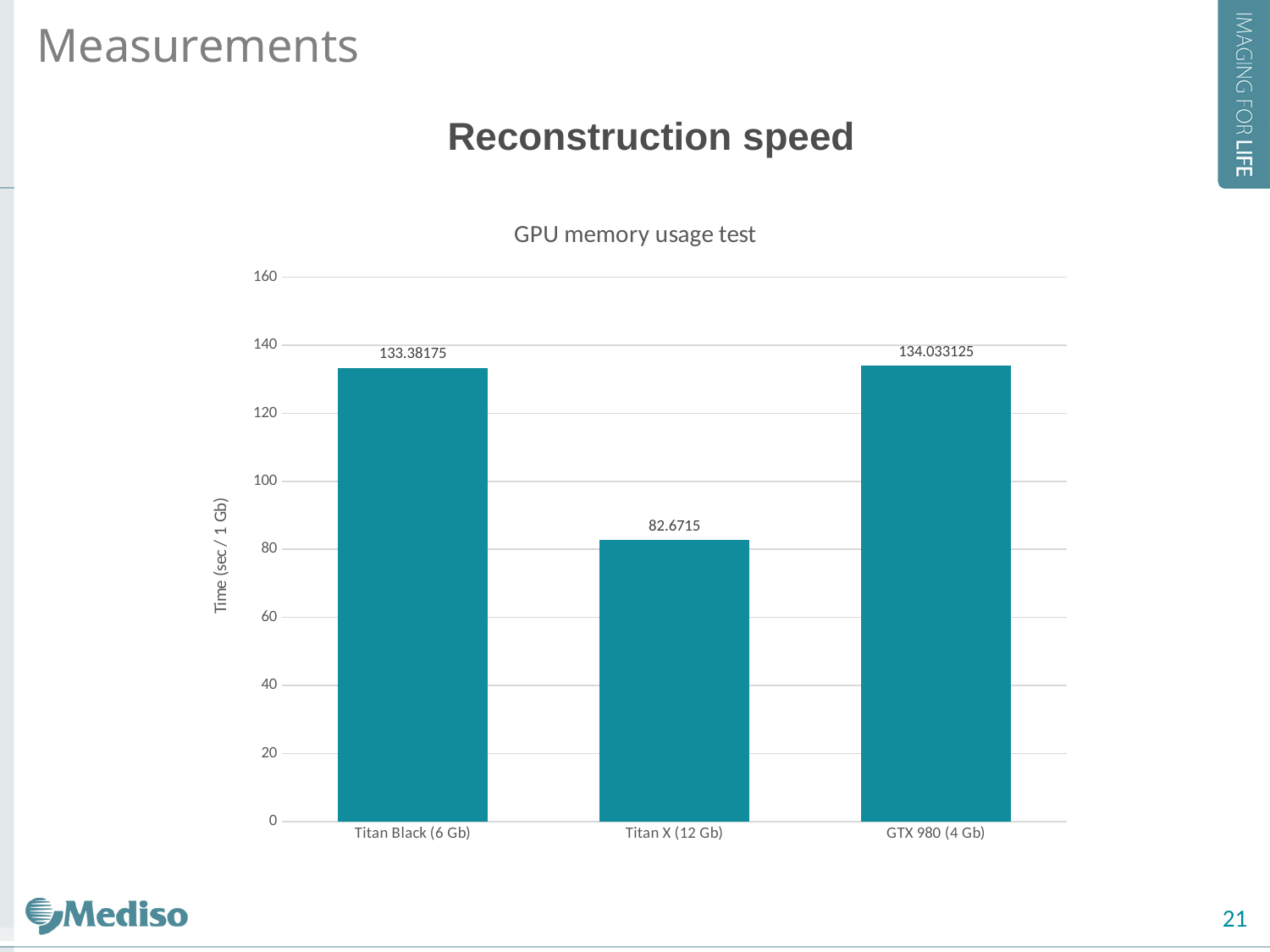
Which GPU has the highest time? GTX 980 (4 Gb) Is the value for Titan X (12 Gb) greater or less than 100? less Which GPU has the lowest time? Titan X (12 Gb) Which is larger, the value for Titan Black (6 Gb) or the value for Titan X (12 Gb)? Titan Black (6 Gb) What is the value for Titan Black (6 Gb)? 133.38175 How many GPUs are shown on the chart? 3 What is the title of the chart? GPU memory usage test What is the value for GTX 980 (4 Gb)? 134.033125 What is the difference between the values for Titan Black (6 Gb) and Titan X (12 Gb)? 50.71025 What is the value for Titan X (12 Gb)? 82.6715 What kind of chart is shown? bar chart What is the difference between the values for GTX 980 (4 Gb) and Titan X (12 Gb)? 51.361625